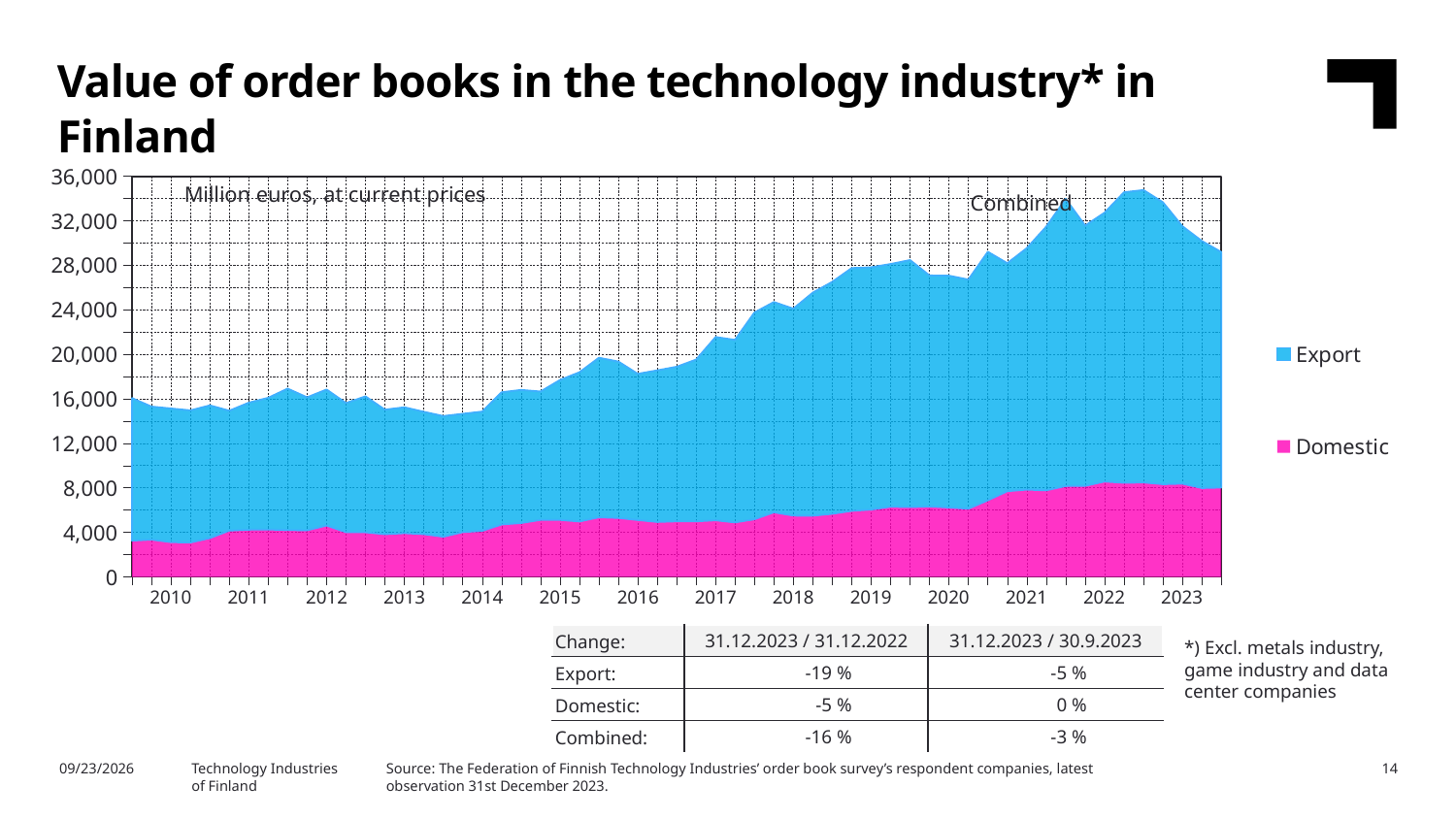
In what unit are the values on the chart expressed, according to the label inside the plot area? Million euros, at current prices In which year does the combined value of order books reach its highest level? 2022 Is the combined value of order books in 2020 greater or less than 24,000? greater Which two series are listed in the chart's legend? Export and Domestic Is the combined value of order books at its 2022 peak greater or less than 32,000? greater Is the Domestic value at the start of 2010 greater or less than 4,000? less What kind of chart is shown on the slide? Stacked area chart How many series does the chart's legend list? 2 Does the combined value of order books generally rise or fall between 2010 and 2022? rise Which series is larger in 2023, Export or Domestic? Export